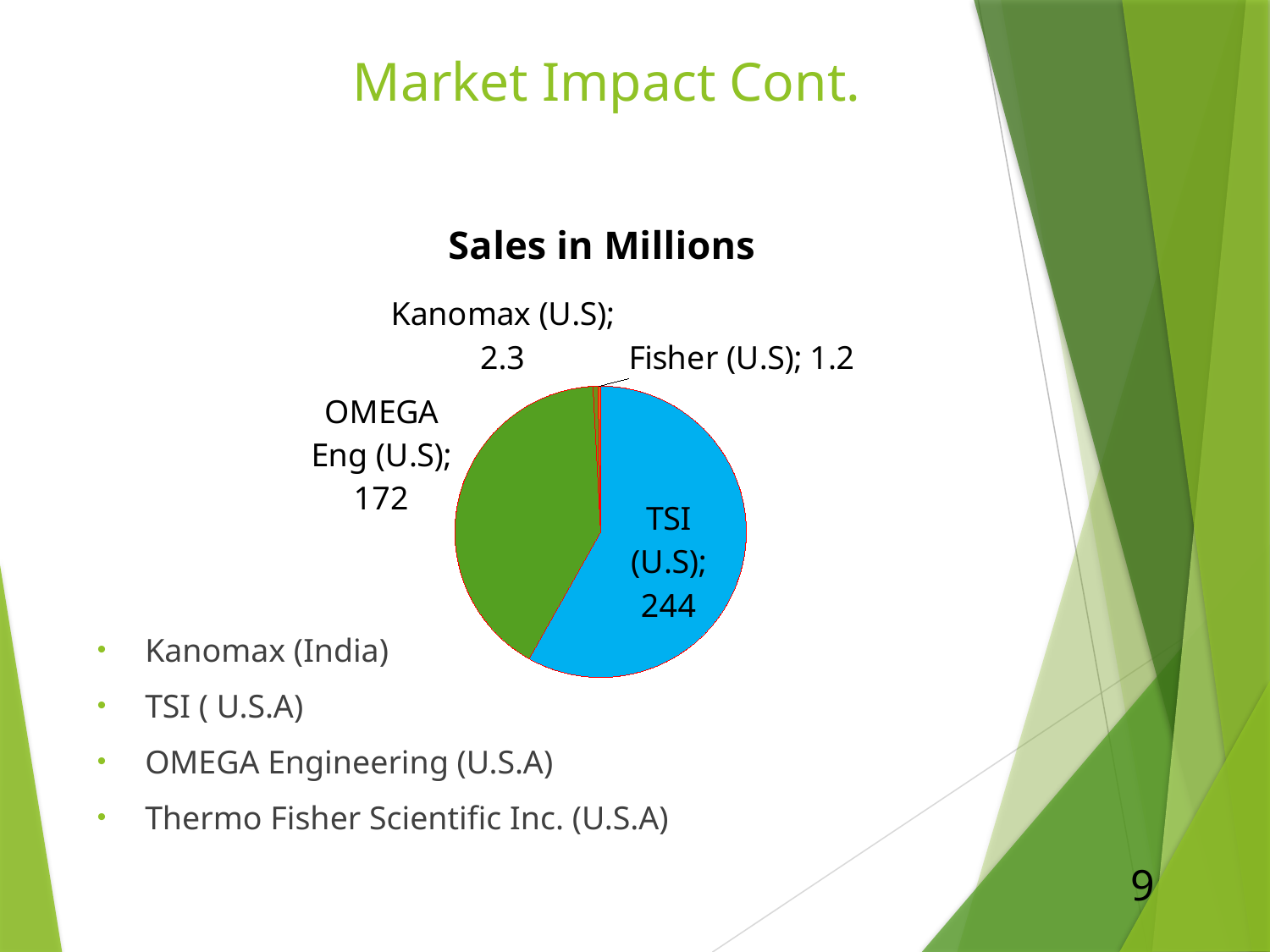
What is the title of the pie chart? Sales in Millions What is the value for Fisher (U.S) in the pie chart? 1.2 What is the value for Kanomax (U.S) in the pie chart? 2.3 What is the difference between the values for TSI (U.S) and OMEGA Eng (U.S)? 72 What type of chart is shown on the slide? pie chart What is the value for TSI (U.S) in the pie chart? 244 Which company has the smallest value in the pie chart? Fisher (U.S) What colour is the TSI (U.S) slice in the pie chart? blue Which is larger, the value for Kanomax (U.S) or Fisher (U.S)? Kanomax (U.S) What is the value for OMEGA Eng (U.S) in the pie chart? 172 How many slices does the pie chart have? 4 Which company has the largest slice in the pie chart? TSI (U.S)